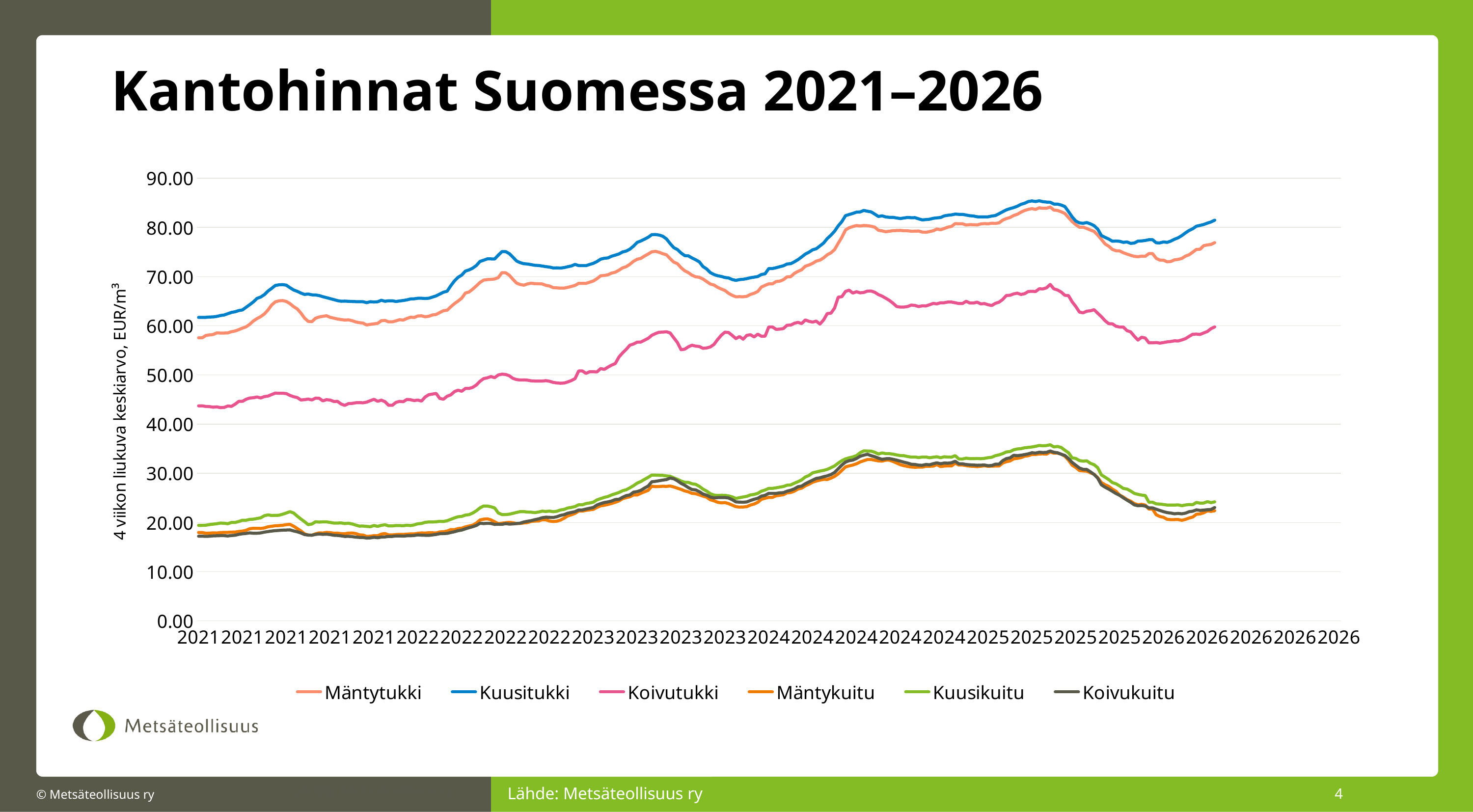
Which series has the highest values across the whole period? Kuusitukki Is the peak value of Kuusitukki in 2025 greater or less than 80.00? greater Which series is higher throughout the period, Kuusitukki or Mäntytukki? Kuusitukki Is the highest value of Kuusikuitu greater or less than 30.00? greater Is the value of Koivutukki at the start of 2021 greater or less than 50.00? less Which series is higher throughout the period, Koivutukki or Kuusikuitu? Koivutukki Which series is plotted in blue? Kuusitukki Does the Koivutukki series generally rise or fall from 2021 to 2024? rise What kind of chart is shown on the slide? line chart How many series does the legend list? 6 What is the title of the chart? Kantohinnat Suomessa 2021–2026